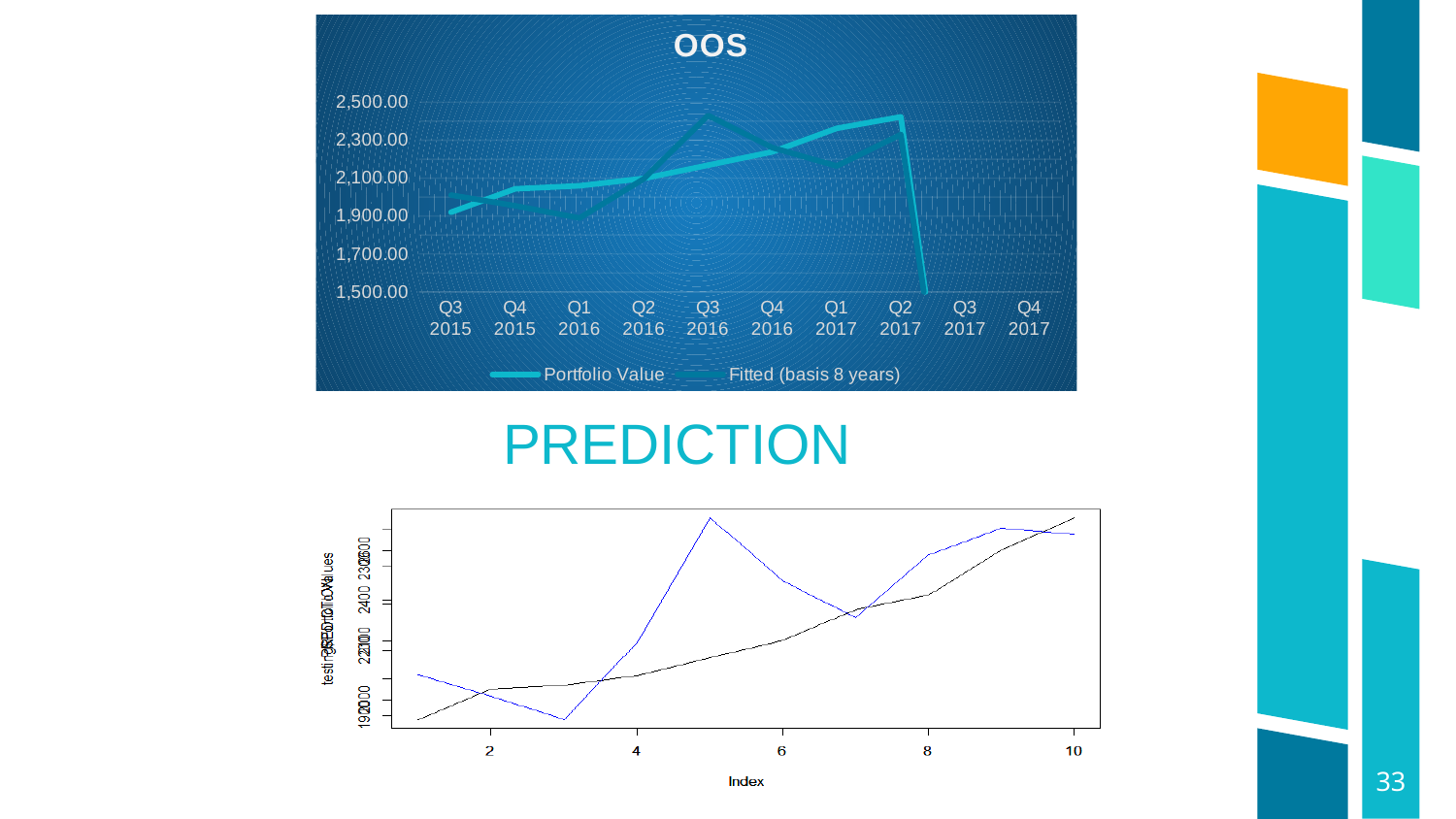
In the top chart titled OOS, what is the lowest value shown on the y axis? 1,500.00 In the top chart titled OOS, what are the two legend entries? Portfolio Value and Fitted (basis 8 years) In the top chart titled OOS, how many series does the legend list? 2 In the top chart titled OOS, how many quarters are shown on the x axis? 10 In the top chart titled OOS, what is the first category on the x axis? Q3 2015 What is the title of the top chart? OOS What kind of chart is the bottom chart under the heading PREDICTION? line chart In the top chart titled OOS, is the value for Q3 2015 greater or less than 2,100.00? less In the bottom chart under the heading PREDICTION, what is the label of the x axis? Index In the bottom chart under the heading PREDICTION, does the black line generally rise or fall as the Index increases? rise What kind of chart is the top chart titled OOS? line chart In the top chart titled OOS, is the peak value reached at Q3 2016 greater or less than 2,300.00? greater